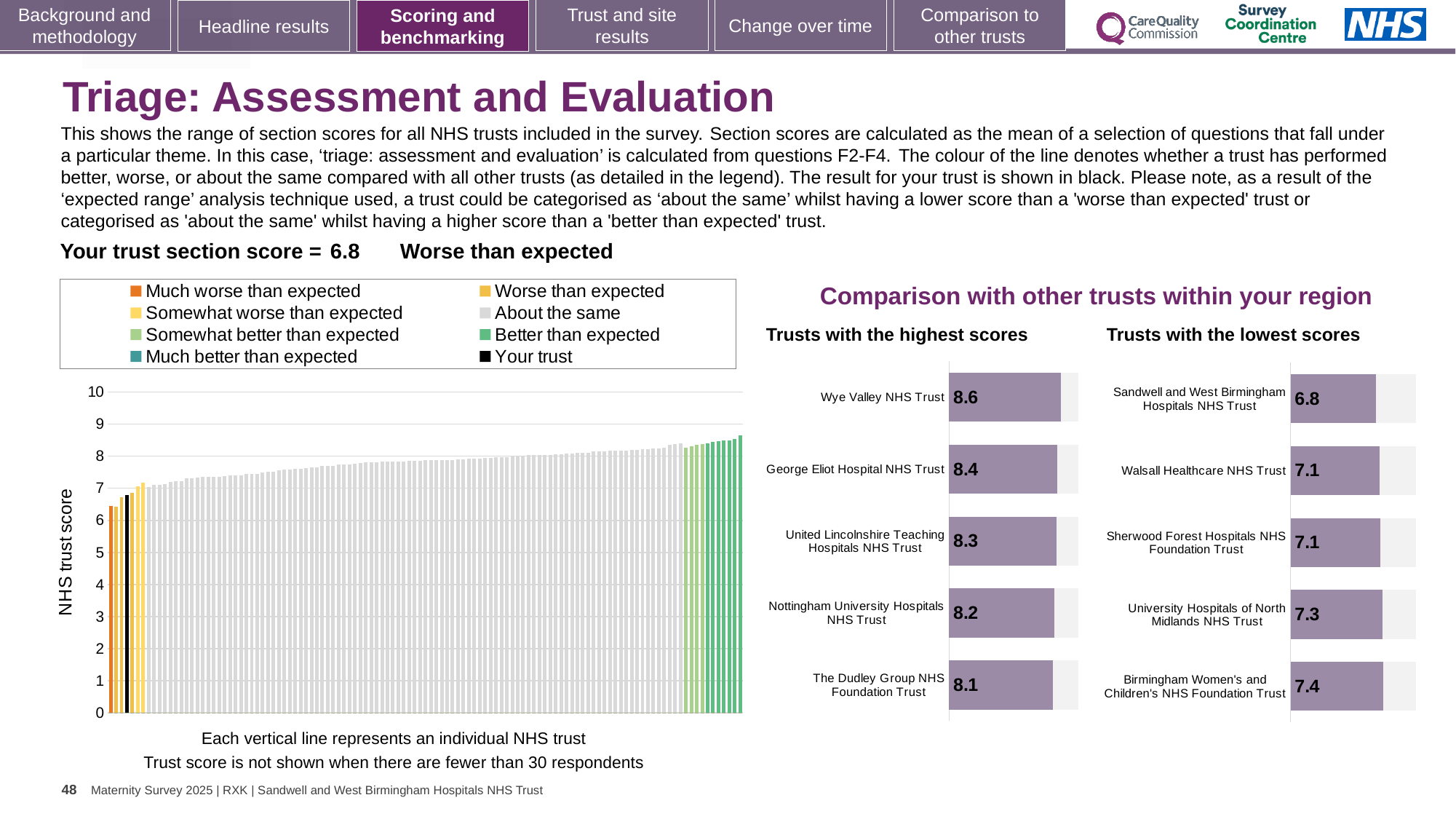
What kind of chart is the 'Trusts with the highest scores' chart? bar chart In the 'Trusts with the highest scores' chart, what is the difference between the scores of Wye Valley NHS Trust and The Dudley Group NHS Foundation Trust? 0.5 In the 'Trusts with the highest scores' chart, which trust has the lowest score shown? The Dudley Group NHS Foundation Trust In the 'Trusts with the lowest scores' chart, which trust has the highest score shown? Birmingham Women's and Children's NHS Foundation Trust In the 'Trusts with the highest scores' chart, how many trusts are listed? 5 In the 'Trusts with the highest scores' chart, what is the score for Wye Valley NHS Trust? 8.6 In the 'Trusts with the lowest scores' chart, what is the score for Walsall Healthcare NHS Trust? 7.1 In the 'Trusts with the lowest scores' chart, which has the larger score: Sandwell and West Birmingham Hospitals NHS Trust or University Hospitals of North Midlands NHS Trust? University Hospitals of North Midlands NHS Trust In the large chart on the left showing all NHS trusts, do the bar values rise or fall from left to right? rise How many entries does the legend above the large chart on the left list? 8 In the 'Trusts with the lowest scores' chart, what is the score for Sherwood Forest Hospitals NHS Foundation Trust? 7.1 In the large chart on the left showing all NHS trusts, is the value for the black 'Your trust' bar greater or less than 7? less